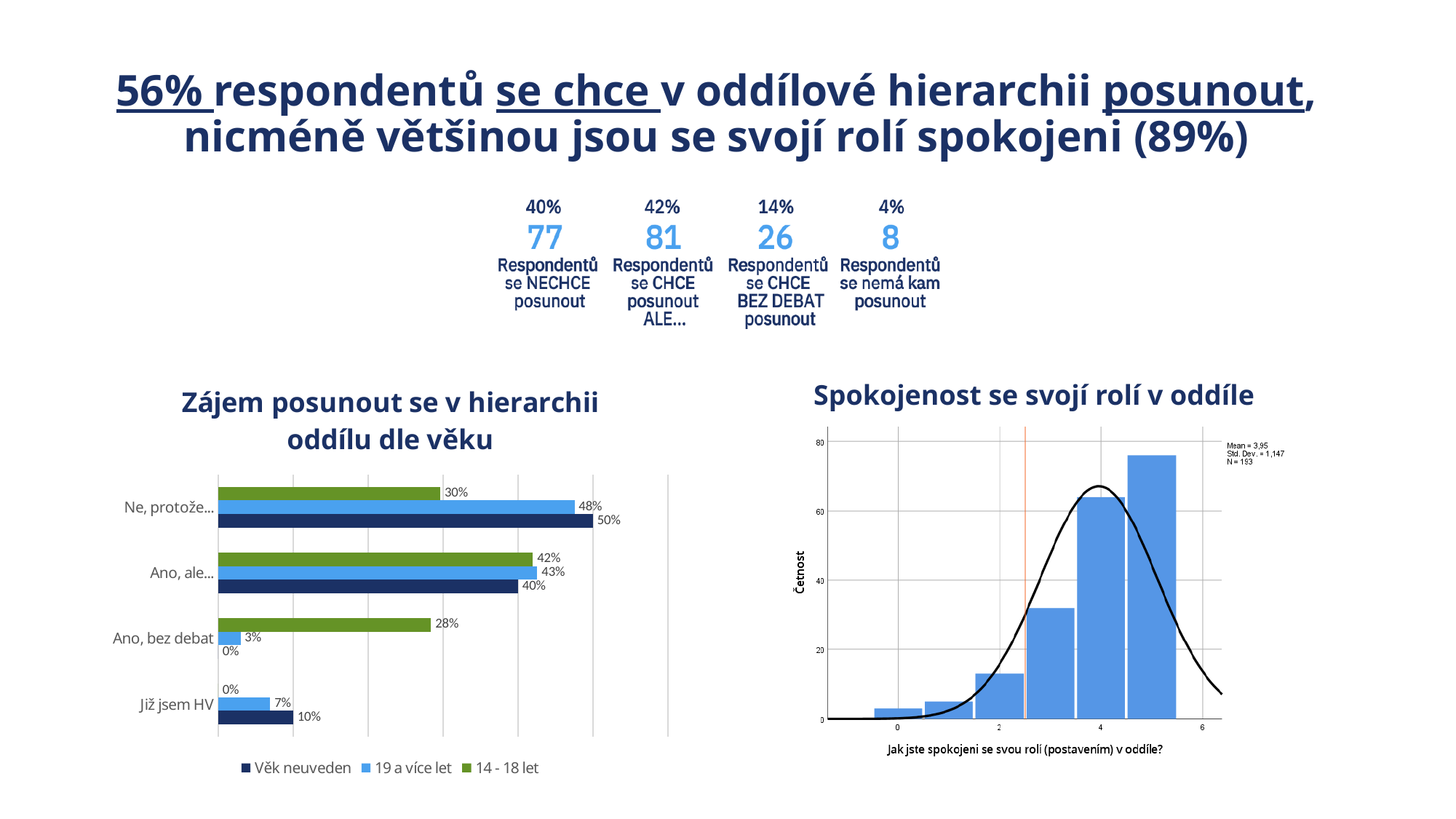
What kind of chart is 'Zájem posunout se v hierarchii oddílu dle věku'? Bar chart In the chart 'Zájem posunout se v hierarchii oddílu dle věku', which category has the highest value for the '14 - 18 let' series? Ano, ale... In the chart 'Zájem posunout se v hierarchii oddílu dle věku', what is the value for '19 a více let' in the category 'Již jsem HV'? 7% How many categories are shown in the chart 'Zájem posunout se v hierarchii oddílu dle věku'? 4 In the chart 'Spokojenost se svojí rolí v oddíle', is the bar at x = 4 greater or less than 60? greater In the chart 'Spokojenost se svojí rolí v oddíle', which x-axis value has the tallest bar? 5 In the chart 'Zájem posunout se v hierarchii oddílu dle věku', which is larger in the category 'Již jsem HV': 'Věk neuveden' or '19 a více let'? Věk neuveden What is the mean value printed on the chart 'Spokojenost se svojí rolí v oddíle'? 3,95 How many series does the legend of the chart 'Zájem posunout se v hierarchii oddílu dle věku' list? 3 In the chart 'Zájem posunout se v hierarchii oddílu dle věku', what is the difference between the '19 a více let' and '14 - 18 let' values in the category 'Ne, protože...'? 18% In the chart 'Zájem posunout se v hierarchii oddílu dle věku', what is the value for 'Věk neuveden' in the category 'Ne, protože...'? 50% In the chart 'Zájem posunout se v hierarchii oddílu dle věku', what is the value for '14 - 18 let' in the category 'Ano, bez debat'? 28%